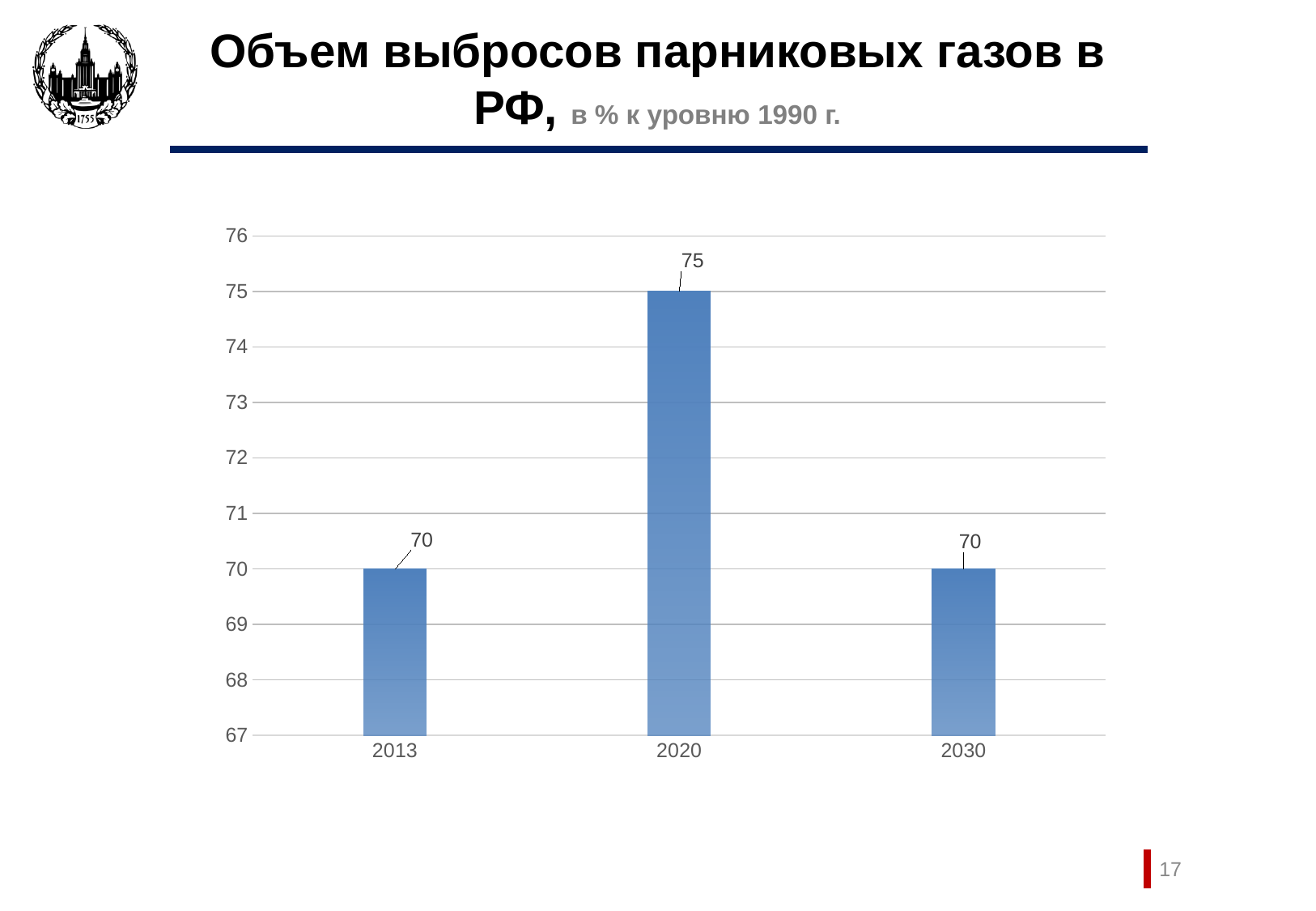
What is the value for 2013? 70 Which year has the highest value? 2020 What is the value for 2030? 70 How many years are shown on the x axis? 3 What is the title of the slide? Объем выбросов парниковых газов в РФ, в % к уровню 1990 г. What is the difference between the values for 2020 and 2013? 5 What is the value for 2020? 75 Is the value for 2030 greater or less than 73? less What kind of chart is shown on the slide? bar chart Is the value for 2020 greater or less than 72? greater Do the values rise or fall from 2020 to 2030? fall Which is larger, the value for 2020 or the value for 2030? 2020